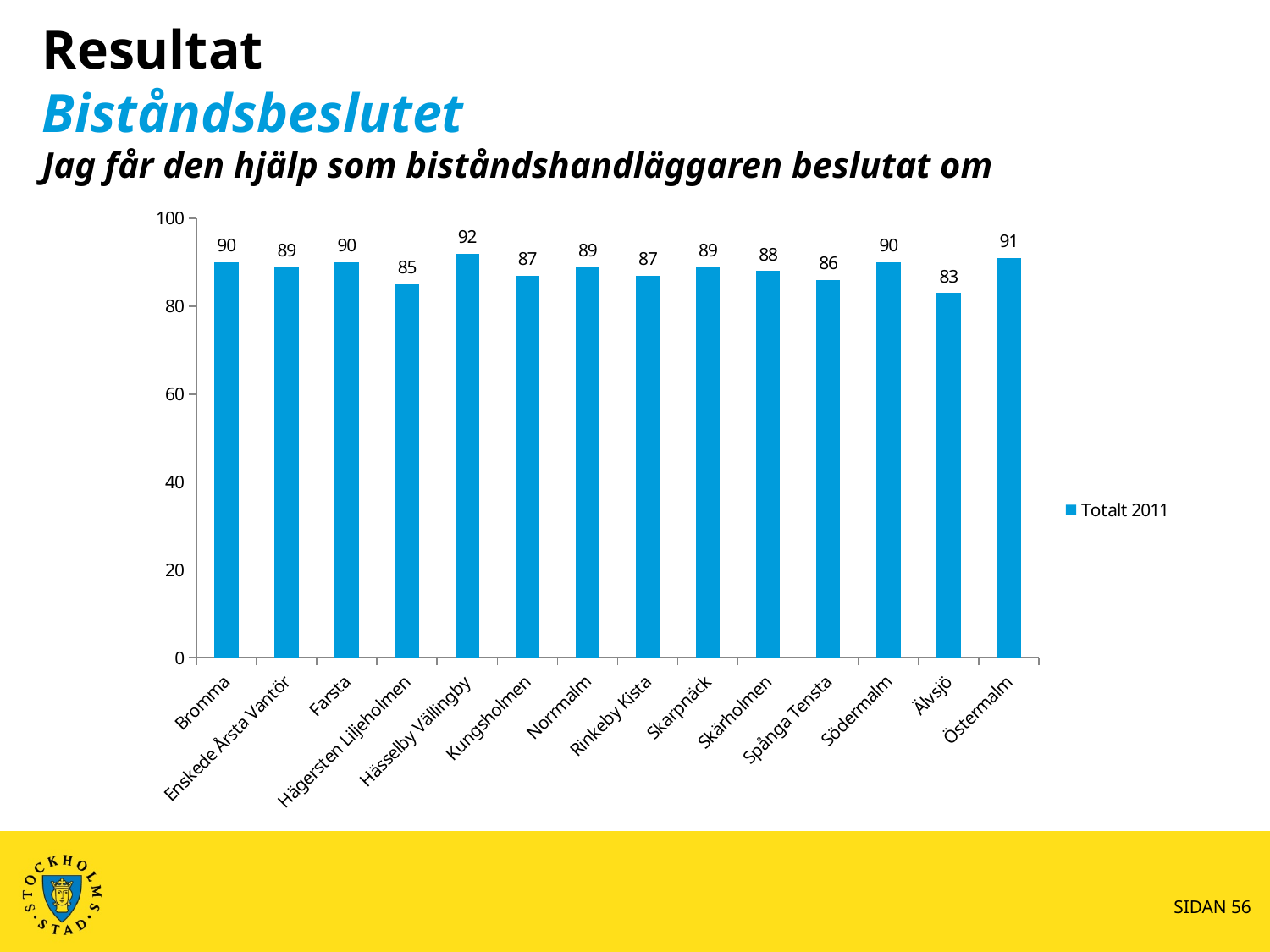
What is the legend entry for the series? Totalt 2011 What is the value for Spånga Tensta? 86 Is the value for Kungsholmen greater or less than 80? greater Which is larger, the value for Östermalm or the value for Hägersten Liljeholmen? Östermalm What is the difference between the values for Hässelby Vällingby and Älvsjö? 9 What is the value for Älvsjö? 83 Which category has the highest value? Hässelby Vällingby How many series does the legend list? 1 How many categories are shown on the x axis? 14 What kind of chart is shown on the slide? bar chart Which category has the lowest value? Älvsjö What is the value for Hässelby Vällingby? 92